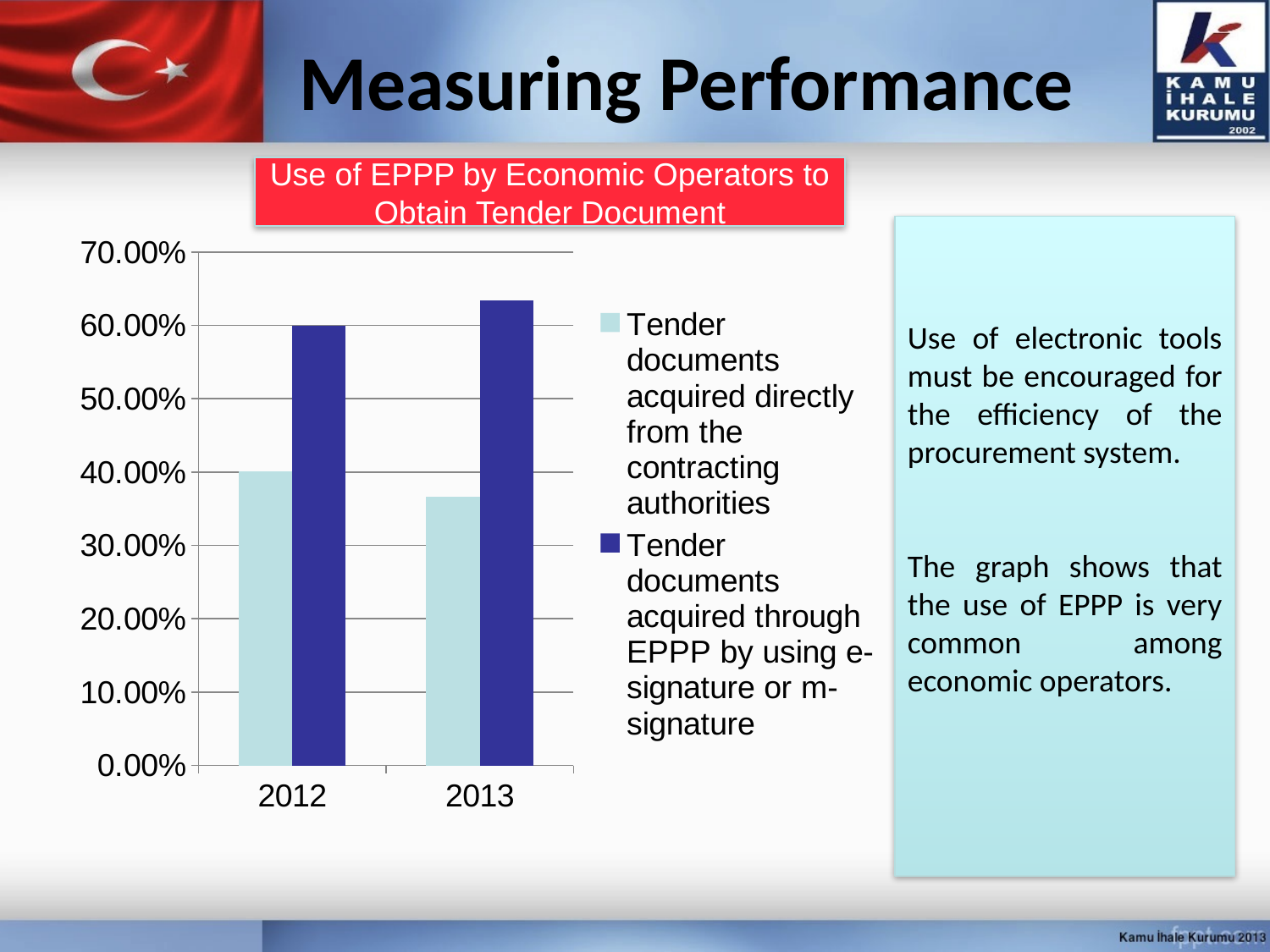
In 2013, which is larger: tender documents acquired directly from the contracting authorities or tender documents acquired through EPPP? Tender documents acquired through EPPP What kind of chart is shown on the slide? bar chart Is the value for tender documents acquired through EPPP in 2013 greater or less than 60.00%? greater In which year is the share of tender documents acquired directly from the contracting authorities lower? 2013 Does the share of tender documents acquired through EPPP rise or fall from 2012 to 2013? rise How many years are shown on the x axis of the chart? 2 What is the title of the chart? Use of EPPP by Economic Operators to Obtain Tender Document Is the value for tender documents acquired directly from the contracting authorities in 2013 greater or less than 40.00%? less In which year is the share of tender documents acquired through EPPP higher? 2013 How many series does the chart legend list? 2